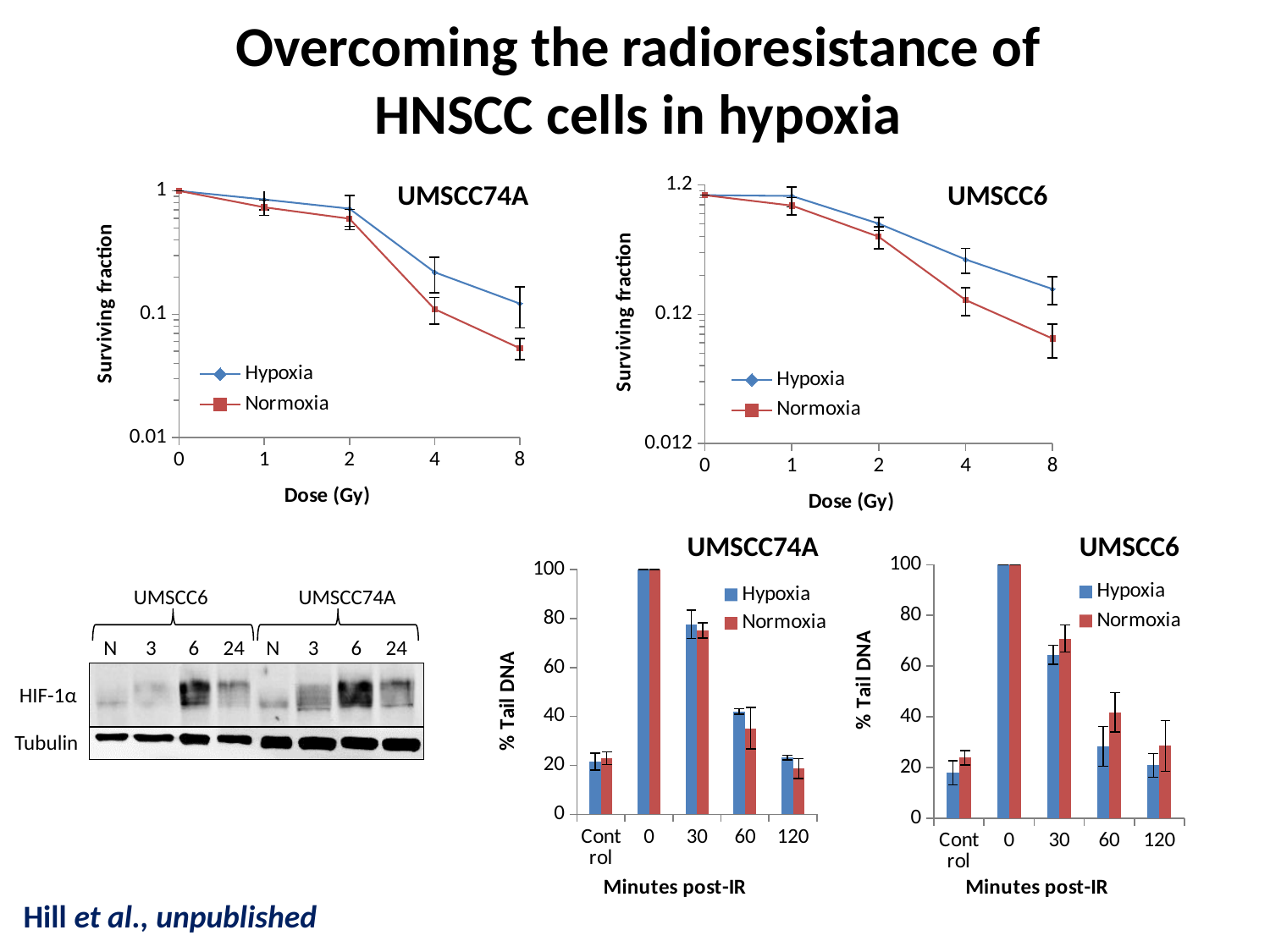
In the top-left UMSCC74A chart, is the Normoxia surviving fraction at 8 Gy greater or less than 0.1? less How many series does the legend of the top-right UMSCC6 chart list? 2 In the bottom-middle UMSCC74A bar chart, what is the % Tail DNA for Hypoxia at 0 minutes post-IR? 100 In the bottom-middle UMSCC74A bar chart, is the Hypoxia value at 30 minutes post-IR greater or less than 60? greater In the bottom-middle UMSCC74A bar chart, how many categories are shown on the x axis? 5 In the top-left UMSCC74A chart, which series has the higher surviving fraction at 8 Gy, Hypoxia or Normoxia? Hypoxia What kind of chart is the top-left UMSCC74A chart? line chart What is the x-axis title of the bottom-right UMSCC6 bar chart? Minutes post-IR In the top-left UMSCC74A chart, does the surviving fraction rise or fall as the dose increases? fall In the bottom-right UMSCC6 bar chart, is the Hypoxia value at 60 minutes post-IR greater or less than 40? less In the bottom-right UMSCC6 bar chart, which series has the larger value at 60 minutes post-IR, Hypoxia or Normoxia? Normoxia